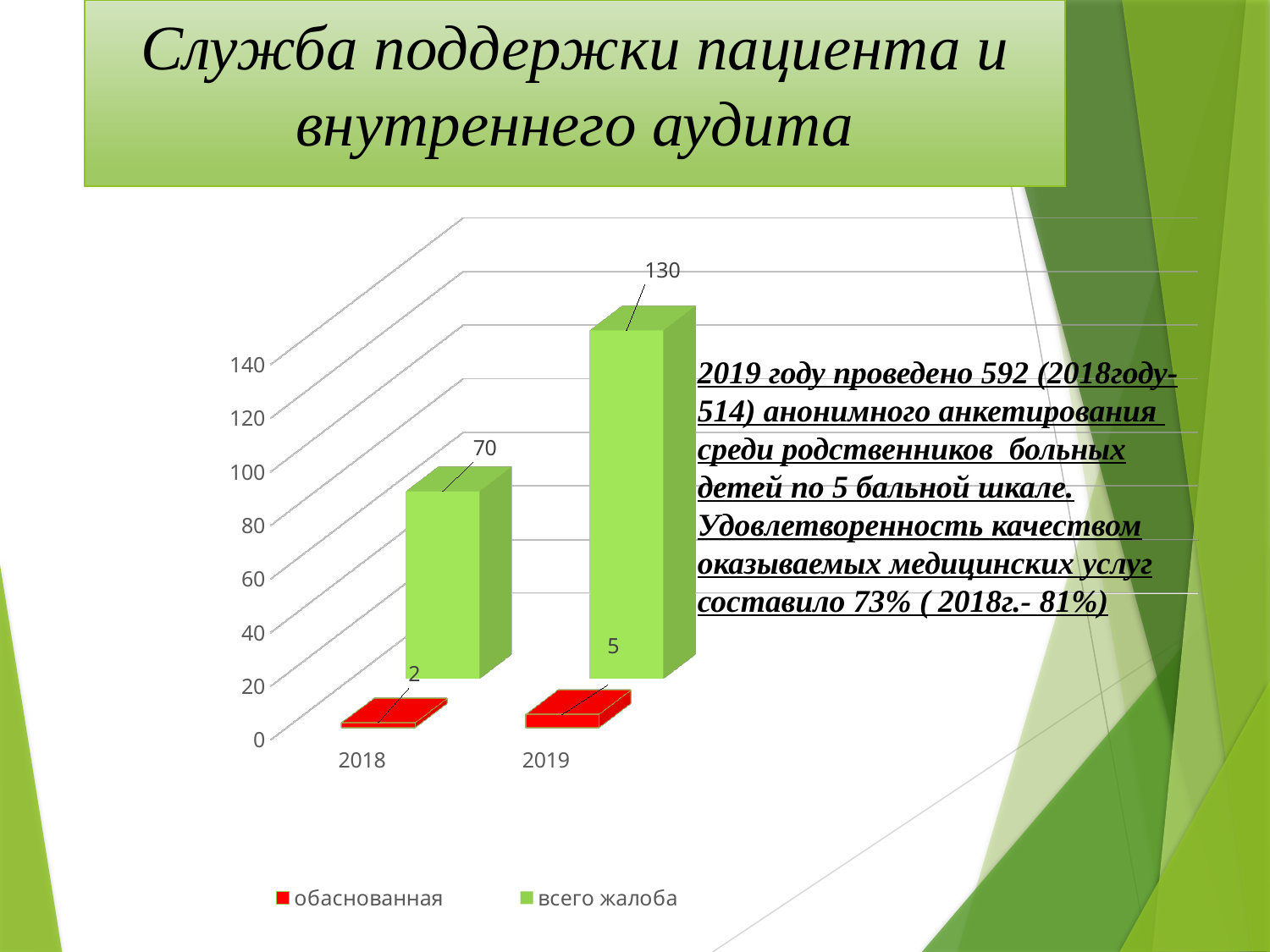
Which colour represents the "обаснованная" series? red What is the value of "всего жалоба" for 2018? 70 What is the difference between the "обаснованная" values for 2019 and 2018? 3 What is the value of "всего жалоба" for 2019? 130 What is the difference between the "всего жалоба" values for 2019 and 2018? 60 How many series does the legend list? 2 What is the value of "обаснованная" for 2018? 2 Which year has the lower value for "обаснованная"? 2018 Is the value of "всего жалоба" for 2018 larger or smaller than the value for 2019? smaller What is the value of "обаснованная" for 2019? 5 What kind of chart is shown on the slide? bar chart Which year has the higher value for "всего жалоба"? 2019